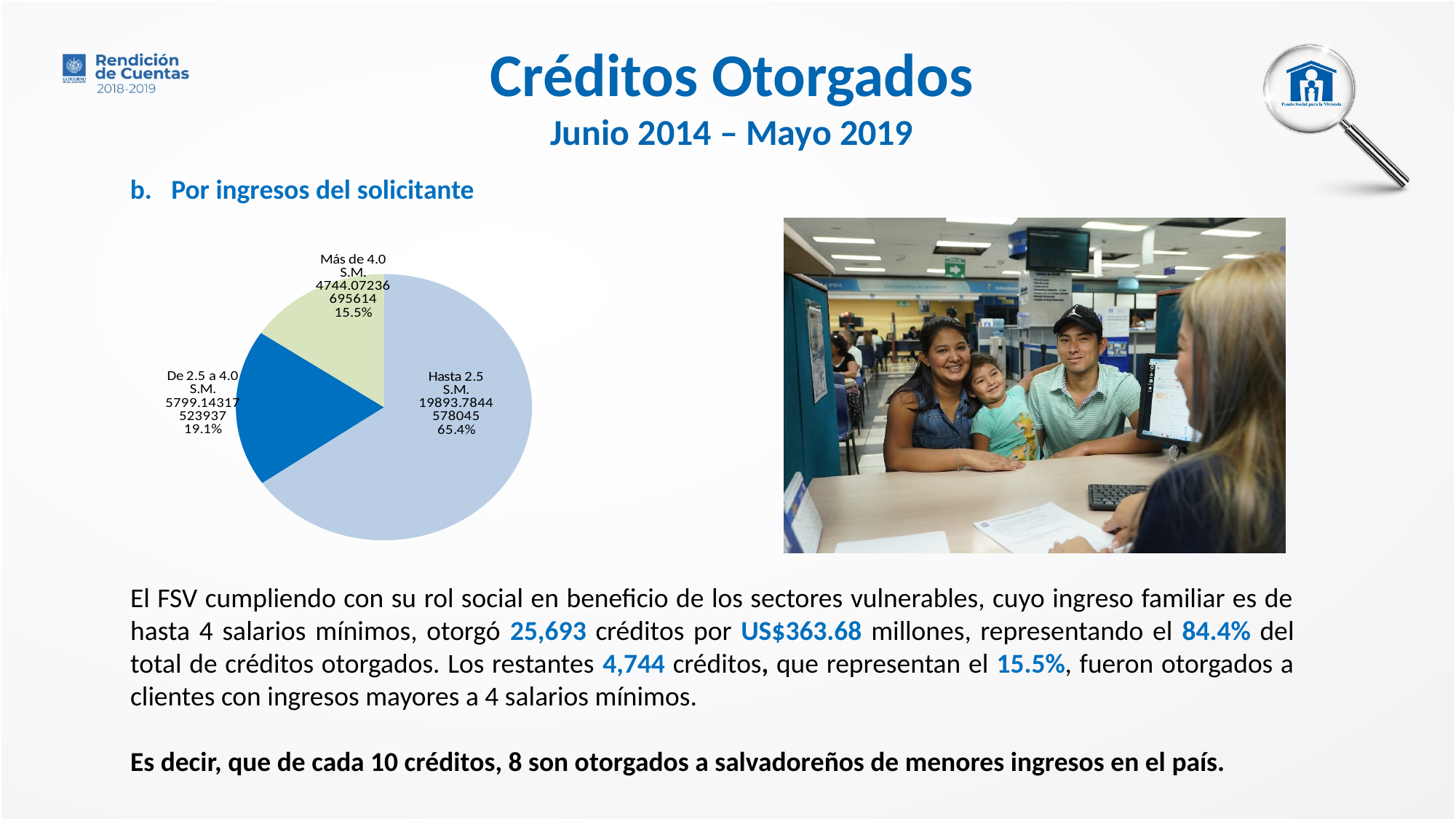
What kind of chart is shown on the slide? pie chart What is the difference in percentage points between the 'Hasta 2.5 S.M.' share and the 'De 2.5 a 4.0 S.M.' share in the pie chart? 46.3 Which category has the largest slice in the pie chart? Hasta 2.5 S.M. Which slice is larger in the pie chart: 'De 2.5 a 4.0 S.M.' or 'Más de 4.0 S.M.'? De 2.5 a 4.0 S.M. What is the heading printed above the pie chart? b. Por ingresos del solicitante How many slices does the pie chart have? 3 What percentage share does the 'Hasta 2.5 S.M.' slice have in the pie chart? 65.4% What percentage share does the 'De 2.5 a 4.0 S.M.' slice have in the pie chart? 19.1% What is the first numeric value printed on the 'Hasta 2.5 S.M.' slice label in the pie chart? 19893.7844 What percentage share does the 'Más de 4.0 S.M.' slice have in the pie chart? 15.5% Which category has the smallest slice in the pie chart? Más de 4.0 S.M. What is the first numeric value printed on the 'Más de 4.0 S.M.' slice label in the pie chart? 4744.07236